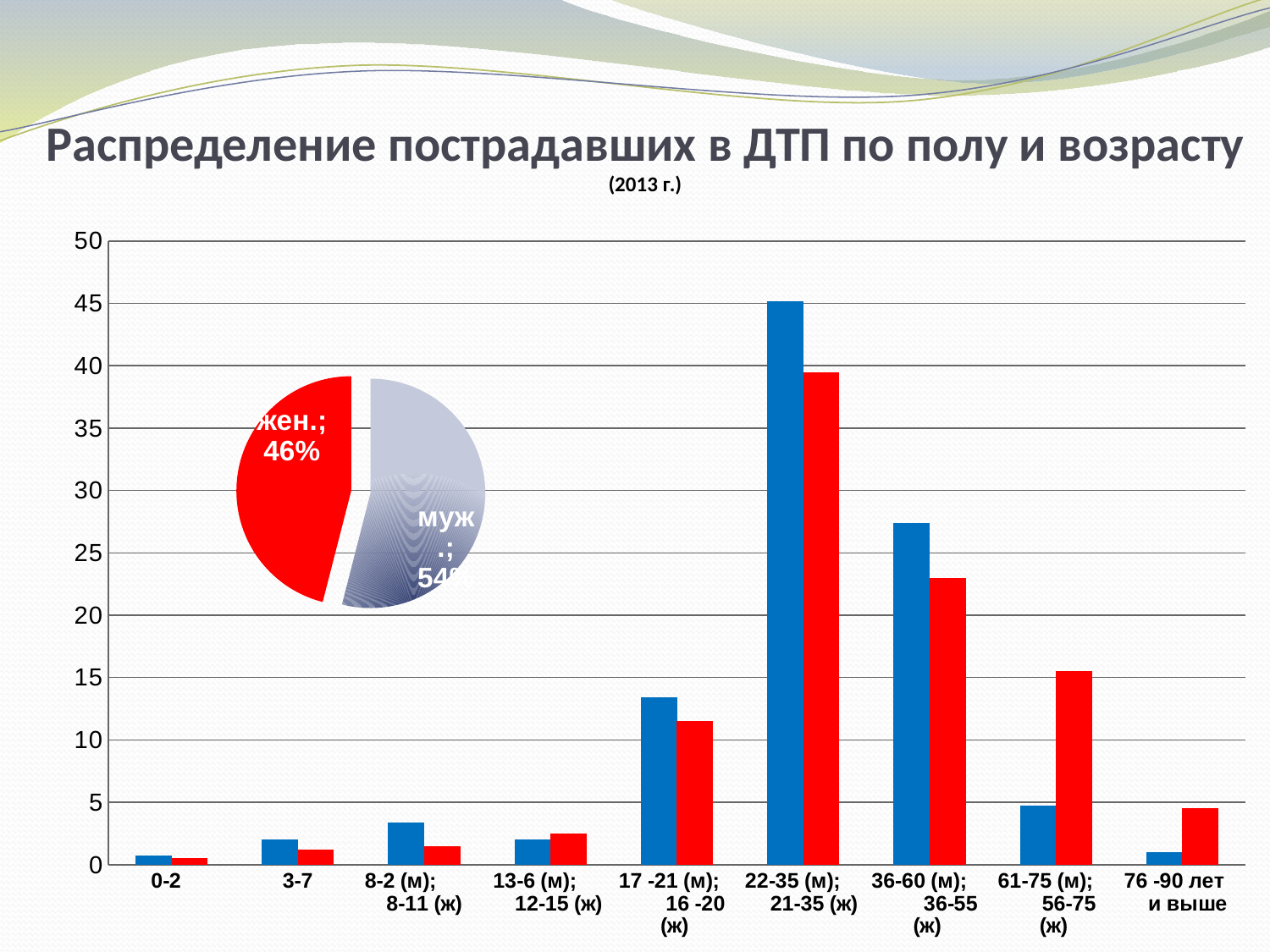
In the bar chart, is the red bar for 36-60 (м); 36-55 (ж) greater or less than 25? less In the bar chart, for the category 61-75 (м); 56-75 (ж), which bar is taller, the blue or the red? red In the pie chart, what share is labelled for муж.? 54% In the pie chart, what share is labelled for жен.? 46% In the bar chart, is the blue bar for 17 -21 (м); 16 -20 (ж) greater or less than 10? greater What is the title of the slide's chart? Распределение пострадавших в ДТП по полу и возрасту In the bar chart, how many age categories are shown on the x axis? 9 In the bar chart, is the red bar for 22-35 (м); 21-35 (ж) greater or less than 35? greater In the bar chart, which category has the tallest blue bar? 22-35 (м); 21-35 (ж) In the pie chart, which slice is larger, жен. or муж.? муж. What kind of chart is the large chart with the age categories on the x axis? bar chart